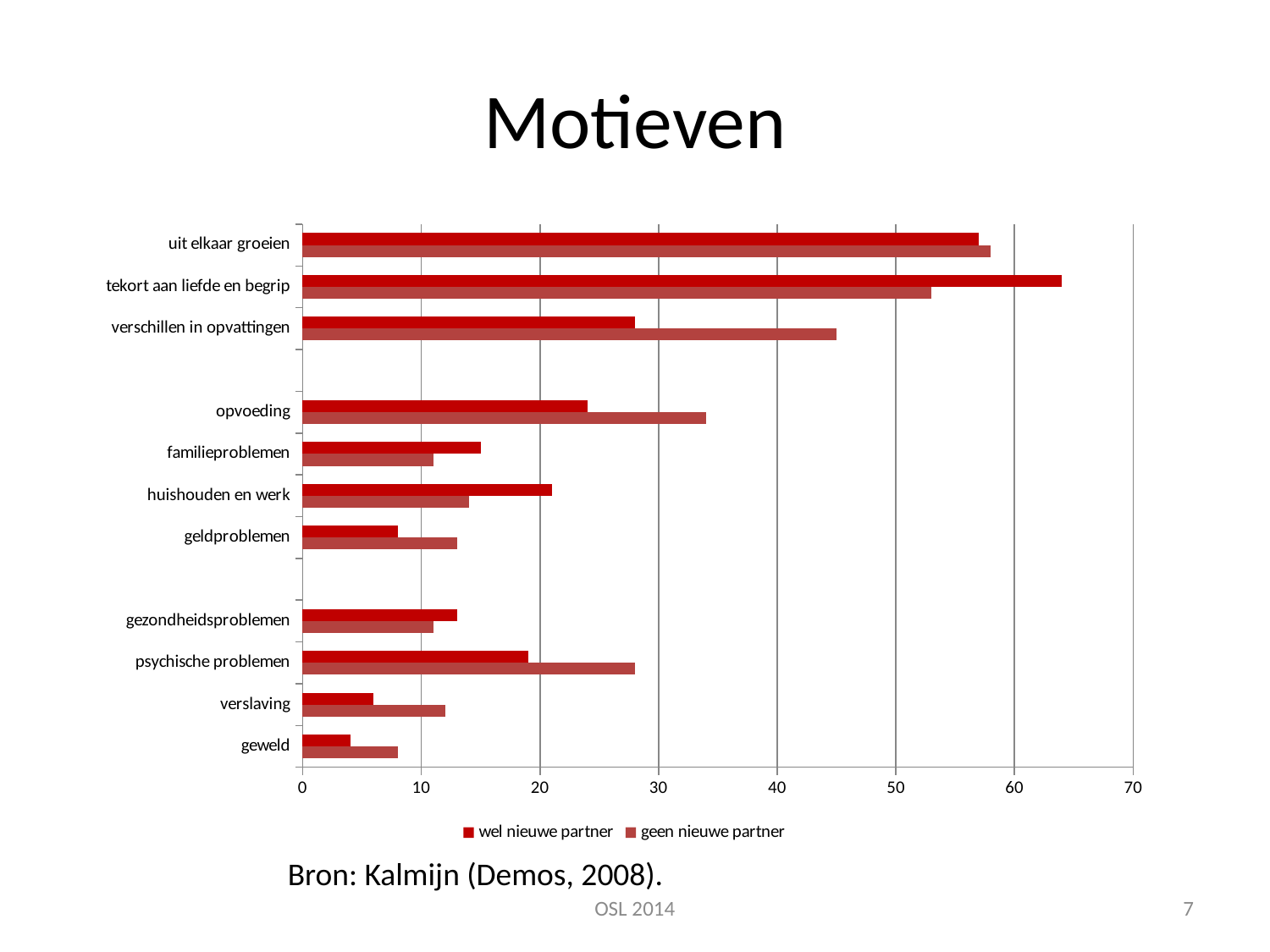
Is the value for 'opvoeding' in the 'geen nieuwe partner' series greater or less than 30? greater Is the value for 'tekort aan liefde en begrip' in the 'wel nieuwe partner' series greater or less than 60? greater For 'verschillen in opvattingen', which series has the larger value: 'wel nieuwe partner' or 'geen nieuwe partner'? geen nieuwe partner How many labelled categories are shown on the vertical axis? 11 Which category has the lowest value for 'geen nieuwe partner'? geweld Which category has the highest value for 'geen nieuwe partner'? uit elkaar groeien Which category has the lowest value for 'wel nieuwe partner'? geweld What is the title of the slide containing the chart? Motieven For 'huishouden en werk', which series has the larger value: 'wel nieuwe partner' or 'geen nieuwe partner'? wel nieuwe partner How many series does the legend list? 2 Which category has the highest value for 'wel nieuwe partner'? tekort aan liefde en begrip What kind of chart is shown on the slide? bar chart